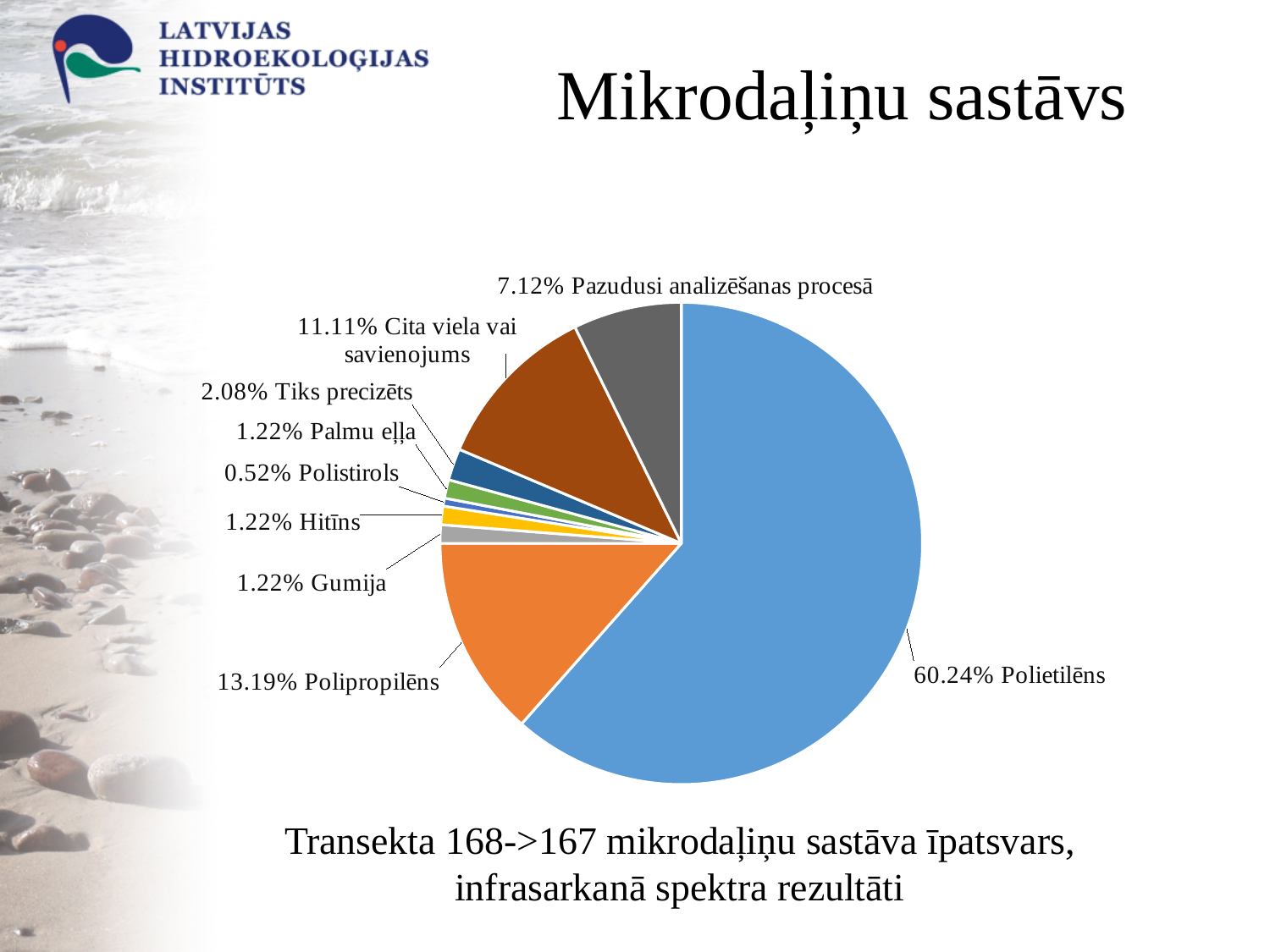
What share of the pie does Polipropilēns have? 13.19% How many slices does the pie chart have? 9 What kind of chart is shown on the slide? pie chart Which category has the largest share of the pie? Polietilēns Which is larger, the share of Cita viela vai savienojums or the share of Pazudusi analizēšanas procesā? Cita viela vai savienojums What is the title of the chart on the slide? Mikrodaļiņu sastāvs What is the value for Cita viela vai savienojums? 11.11% What is the value for Pazudusi analizēšanas procesā? 7.12% What is the value for Tiks precizēts? 2.08% What is the difference between the shares of Polietilēns and Polipropilēns? 47.05% What share of the pie does Polietilēns have? 60.24% Which category has the smallest share of the pie? Polistirols